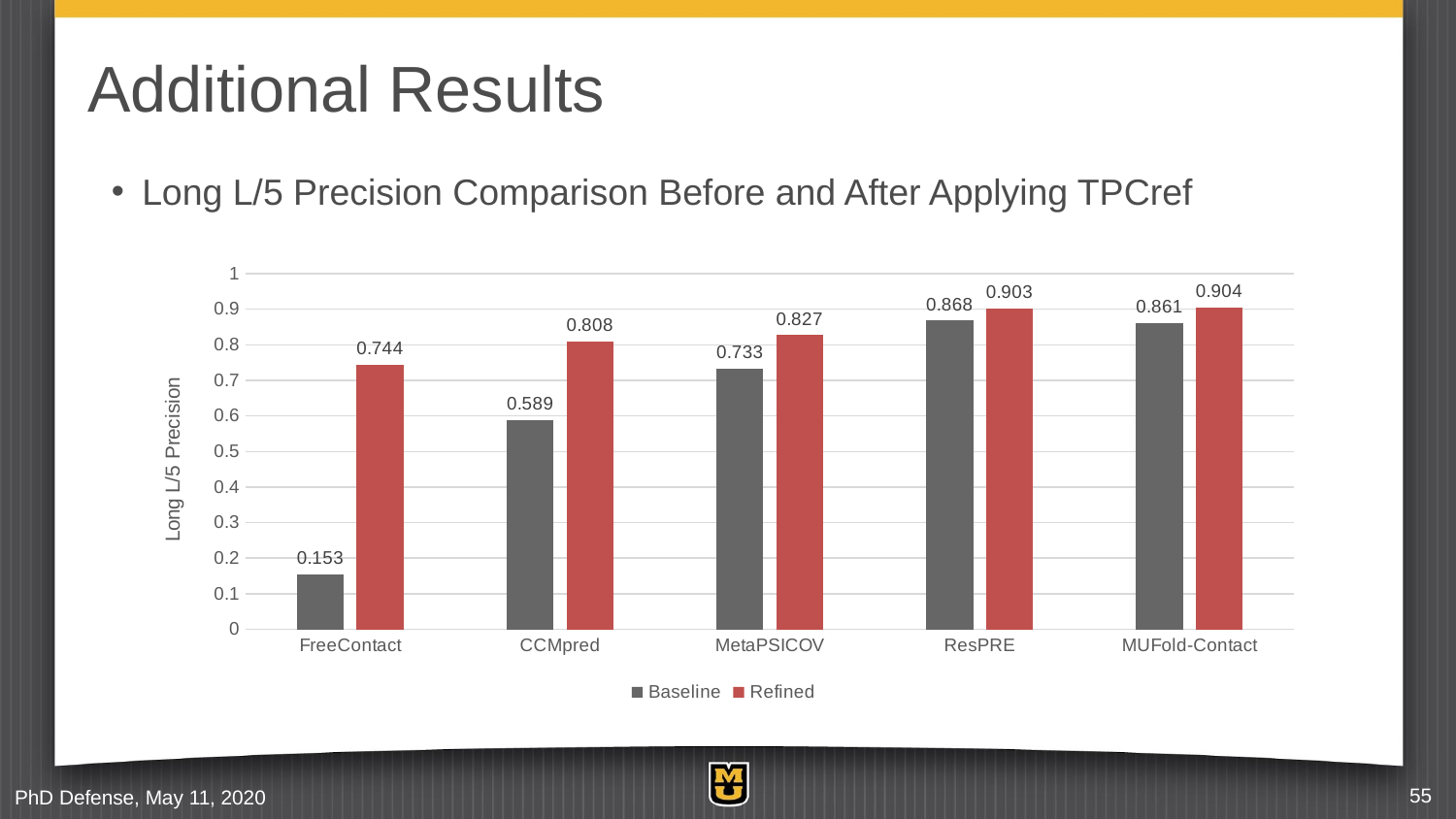
How many series does the legend list? 2 What is the difference between the Refined and Baseline values for CCMpred? 0.219 What is the Baseline value for FreeContact? 0.153 Which is larger, the Baseline value for ResPRE or the Baseline value for MUFold-Contact? ResPRE How many categories are shown on the x axis? 5 What is the Baseline value for MetaPSICOV? 0.733 What is the difference between the Refined and Baseline values for FreeContact? 0.591 What is the Refined value for CCMpred? 0.808 Which category has the highest Baseline value? ResPRE What kind of chart is shown on the slide? Bar chart Which category has the lowest Baseline value? FreeContact What is the label of the y axis? Long L/5 Precision